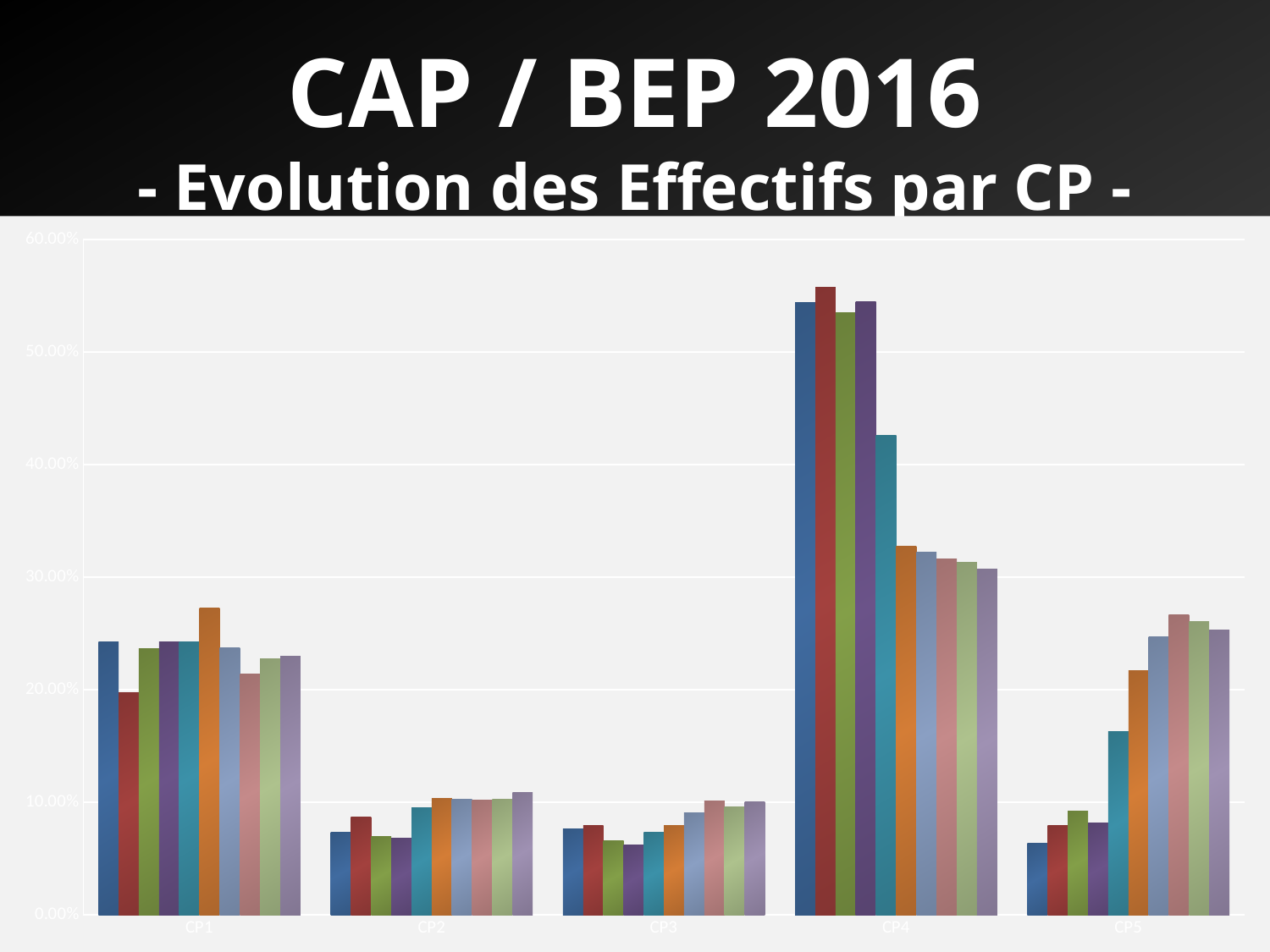
How many bars are plotted for each category in the chart? 10 Which is larger: the leftmost bar for CP4 or the leftmost bar for CP1? CP4 How many categories are shown on the x axis of the chart? 5 Which category has the tallest bars in the chart? CP4 Is the value of the leftmost bar for CP4 greater or less than 50%? greater Is the value of the rightmost bar for CP4 greater or less than 40%? less What kind of chart is shown on the slide? bar chart Is the value of the leftmost bar for CP1 greater or less than 20%? greater Within the CP5 group, do the bars generally rise or fall from left to right? rise What is the title of the slide containing the chart? CAP / BEP 2016 - Evolution des Effectifs par CP -